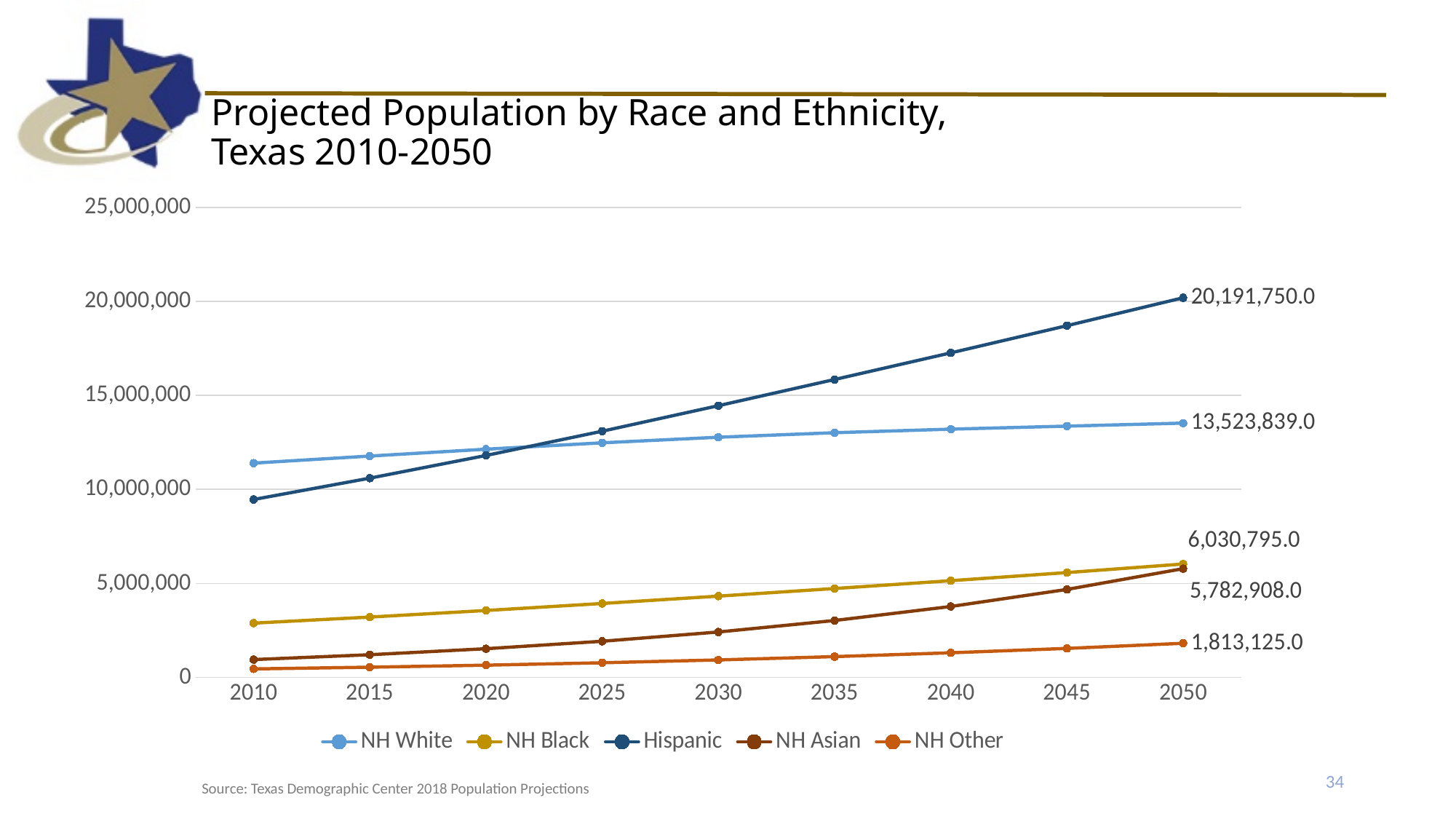
Which group has the lowest projected population in 2050? NH Other What is the difference between the Hispanic and NH White projected populations in 2050? 6,667,911.0 What is the projected Hispanic population in 2050? 20,191,750.0 What is the projected NH Other population in 2050? 1,813,125.0 Does the Hispanic population rise or fall from 2010 to 2050? rise What kind of chart is shown on the slide? line chart What is the projected NH White population in 2050? 13,523,839.0 How many years are shown on the x axis? 9 Is the Hispanic population in 2010 greater or less than 10,000,000? less In 2010, which group has the larger population, NH White or Hispanic? NH White Which group has the highest projected population in 2050? Hispanic How many series does the legend list? 5